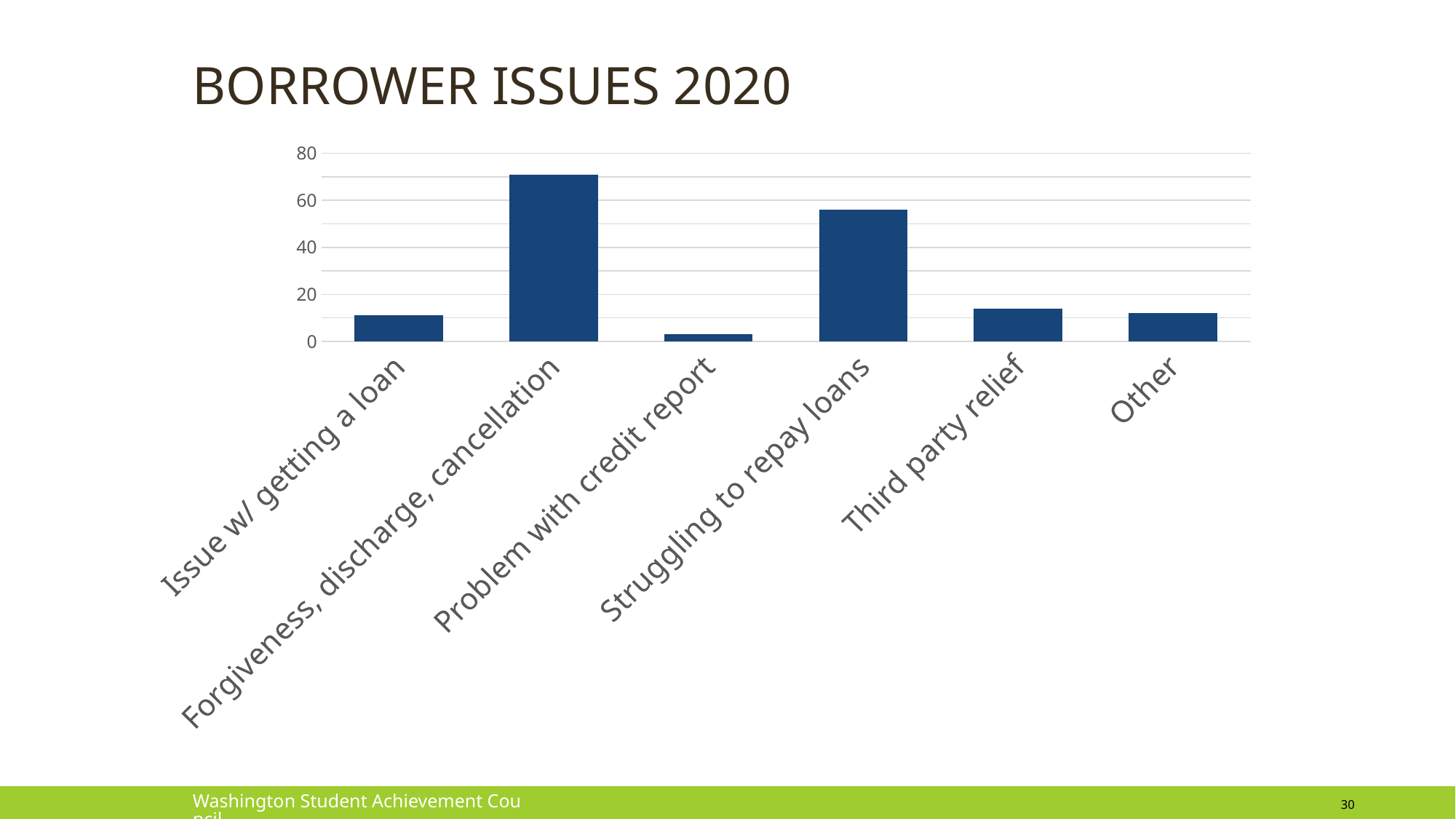
What kind of chart is shown on the slide? bar chart Is the value for Third party relief greater or less than 20? less Is the value for Problem with credit report greater or less than 20? less Which category has the highest value? Forgiveness, discharge, cancellation Is the value for Struggling to repay loans greater or less than 40? greater Which is larger, the value for Forgiveness, discharge, cancellation or the value for Struggling to repay loans? Forgiveness, discharge, cancellation Which category has the lowest value? Problem with credit report What is the title of the chart? BORROWER ISSUES 2020 Which is larger, the value for Third party relief or the value for Problem with credit report? Third party relief How many categories are shown on the x axis? 6